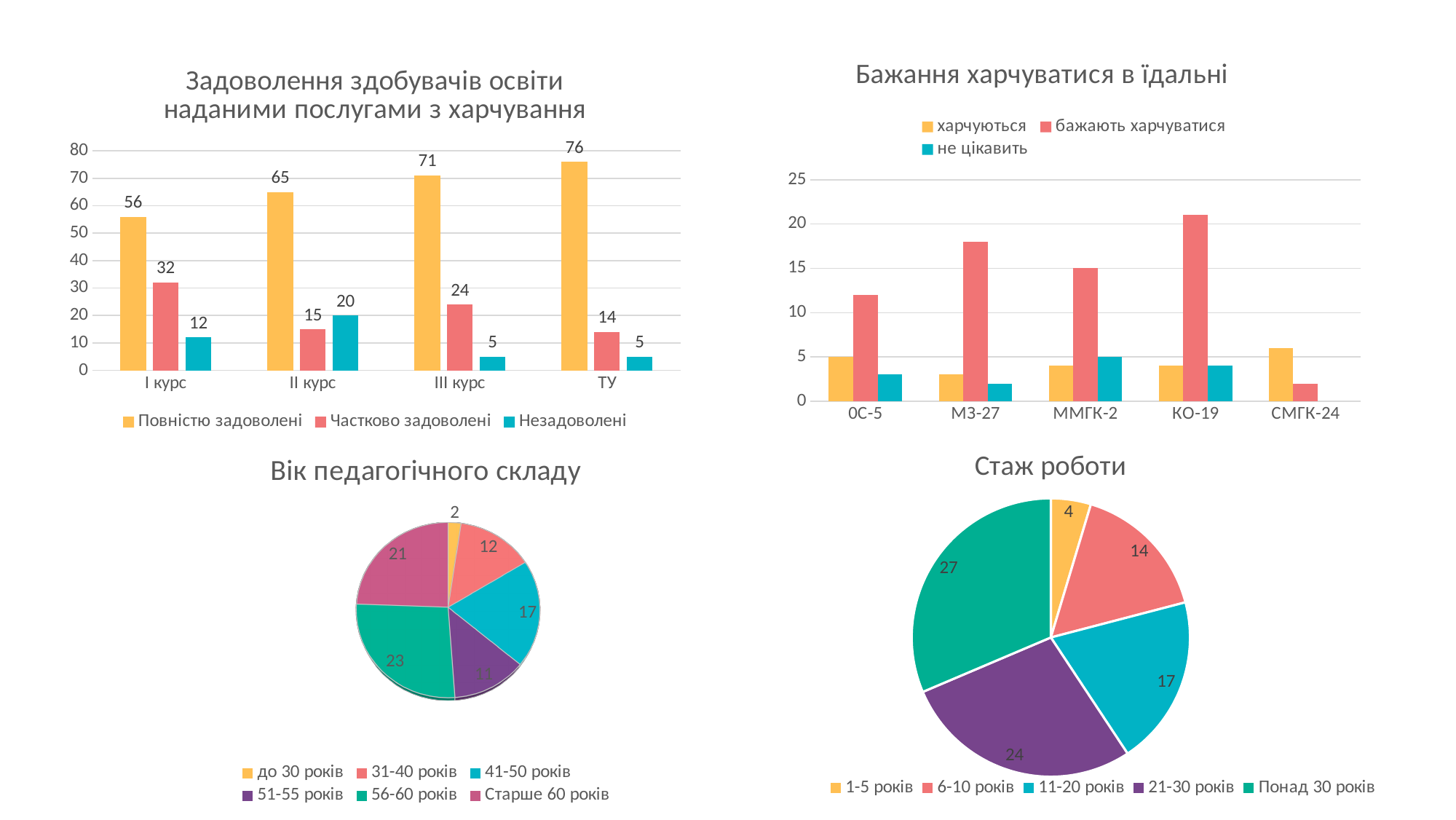
In the chart 'Задоволення здобувачів освіти наданими послугами з харчування', what is the value for 'Повністю задоволені' for ТУ? 76 What kind of chart is 'Вік педагогічного складу'? pie chart In the chart 'Бажання харчуватися в їдальні', is the value for 'бажають харчуватися' for КО-19 greater or less than 20? greater In the chart 'Бажання харчуватися в їдальні', how many categories are shown on the x axis? 5 In the pie chart 'Стаж роботи', what is the value for '21-30 років'? 24 In the chart 'Задоволення здобувачів освіти наданими послугами з харчування', what is the value for 'Незадоволені' for ІІ курс? 20 In the pie chart 'Вік педагогічного складу', which slice is the smallest? до 30 років In the chart 'Задоволення здобувачів освіти наданими послугами з харчування', which category has the highest value for 'Повністю задоволені'? ТУ In the chart 'Бажання харчуватися в їдальні', which category has the highest value for 'бажають харчуватися'? КО-19 In the chart 'Задоволення здобувачів освіти наданими послугами з харчування', how many series does the legend list? 3 In the chart 'Бажання харчуватися в їдальні', is the value for 'харчуються' for МЗ-27 greater or less than 5? less In the chart 'Задоволення здобувачів освіти наданими послугами з харчування', what is the difference between 'Повністю задоволені' and 'Частково задоволені' for І курс? 24